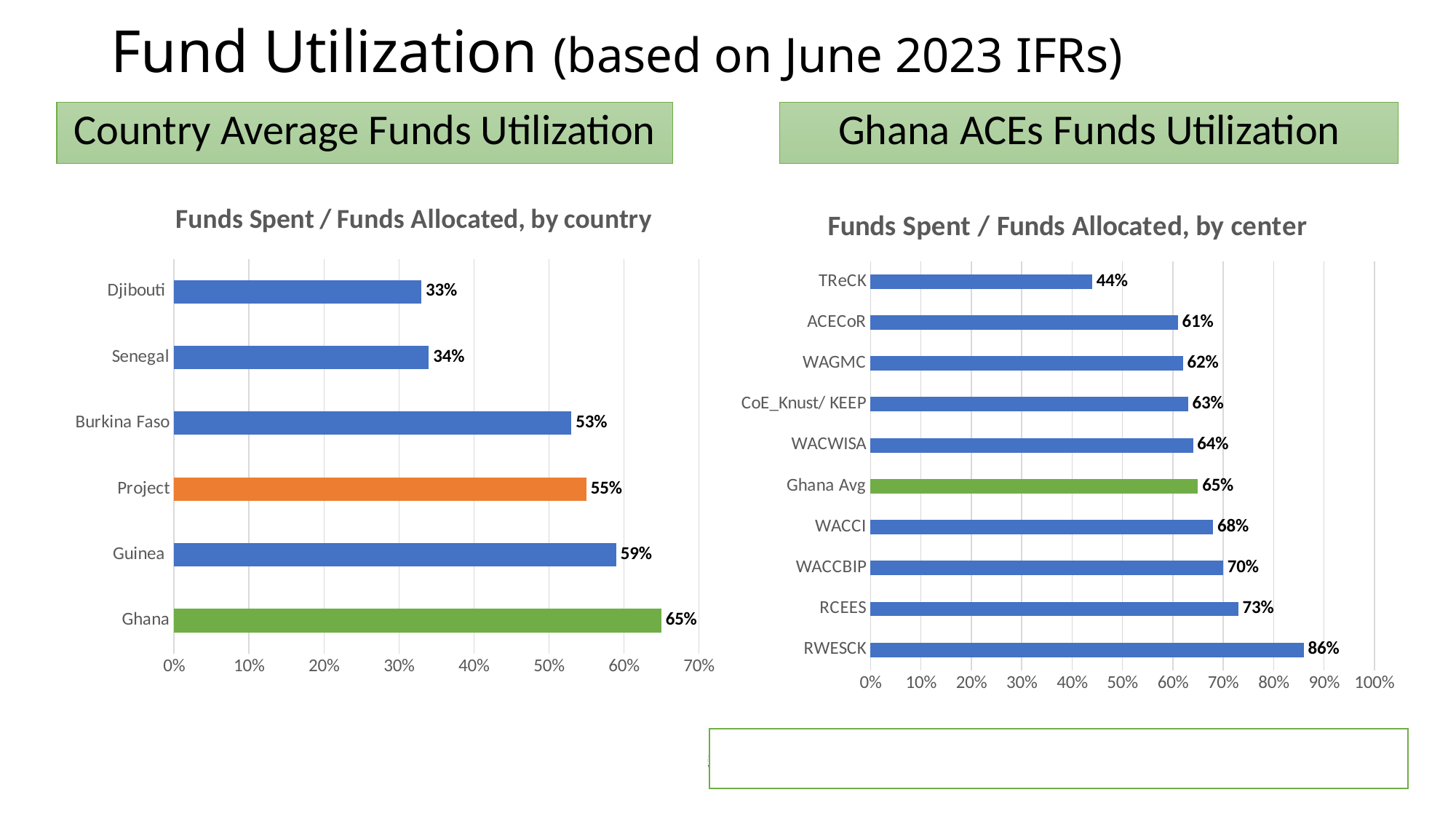
In the 'Funds Spent / Funds Allocated, by country' chart, what is the value for Djibouti? 33% In the 'Funds Spent / Funds Allocated, by center' chart, what is the value for RWESCK? 86% In the 'Funds Spent / Funds Allocated, by center' chart, which is larger, WACCI or WACCBIP? WACCBIP In the 'Funds Spent / Funds Allocated, by country' chart, what is the difference between Ghana and Guinea? 6% In the 'Funds Spent / Funds Allocated, by center' chart, what is the difference between RWESCK and TReCK? 42% In the 'Funds Spent / Funds Allocated, by country' chart, what is the value for Project? 55% In the 'Funds Spent / Funds Allocated, by country' chart, which category has the highest value? Ghana What kind of chart is the 'Funds Spent / Funds Allocated, by center' chart? Bar chart In the 'Funds Spent / Funds Allocated, by center' chart, which center has the lowest value? TReCK In the 'Funds Spent / Funds Allocated, by center' chart, how many bars are plotted? 10 In the 'Funds Spent / Funds Allocated, by country' chart, which category has the lowest value? Djibouti In the 'Funds Spent / Funds Allocated, by country' chart, how many bars are plotted? 6